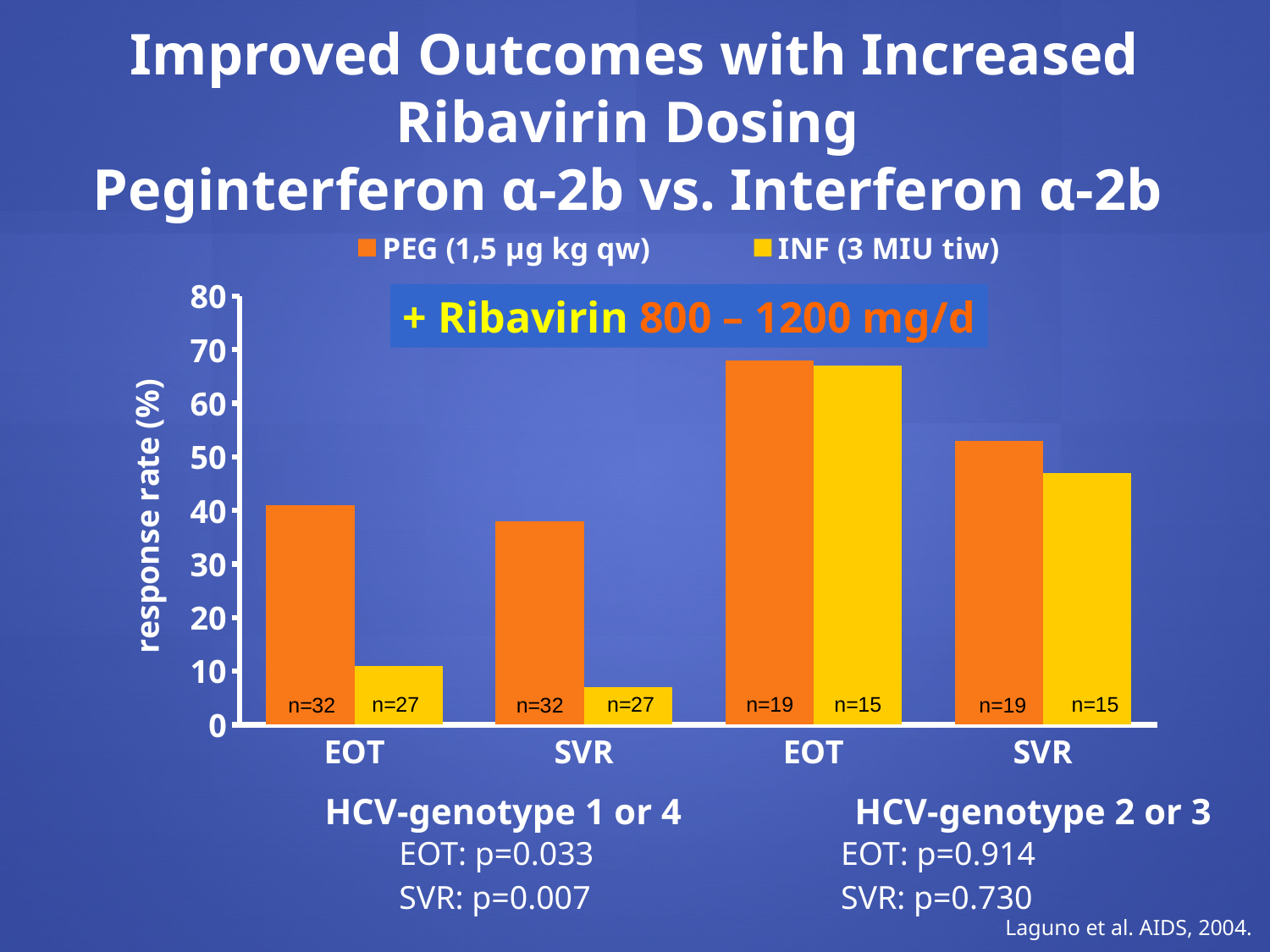
Which bar has the lowest response rate in the chart? INF, SVR, HCV-genotype 1 or 4 Is the INF response rate for SVR in HCV-genotype 1 or 4 greater or less than 10? less How many category groups are shown along the x axis? 4 Is the PEG response rate for EOT in HCV-genotype 2 or 3 greater or less than 60? greater For SVR in HCV-genotype 2 or 3, which series has the higher response rate, PEG or INF? PEG What is the n value shown for the INF bars in HCV-genotype 2 or 3? n=15 Is the INF response rate for EOT in HCV-genotype 1 or 4 greater or less than 20? less What kind of chart is shown on the slide? bar chart How many series does the legend list? 2 What are the two series named in the legend? PEG (1,5 µg kg qw) and INF (3 MIU tiw) What is the label of the y axis? response rate (%)